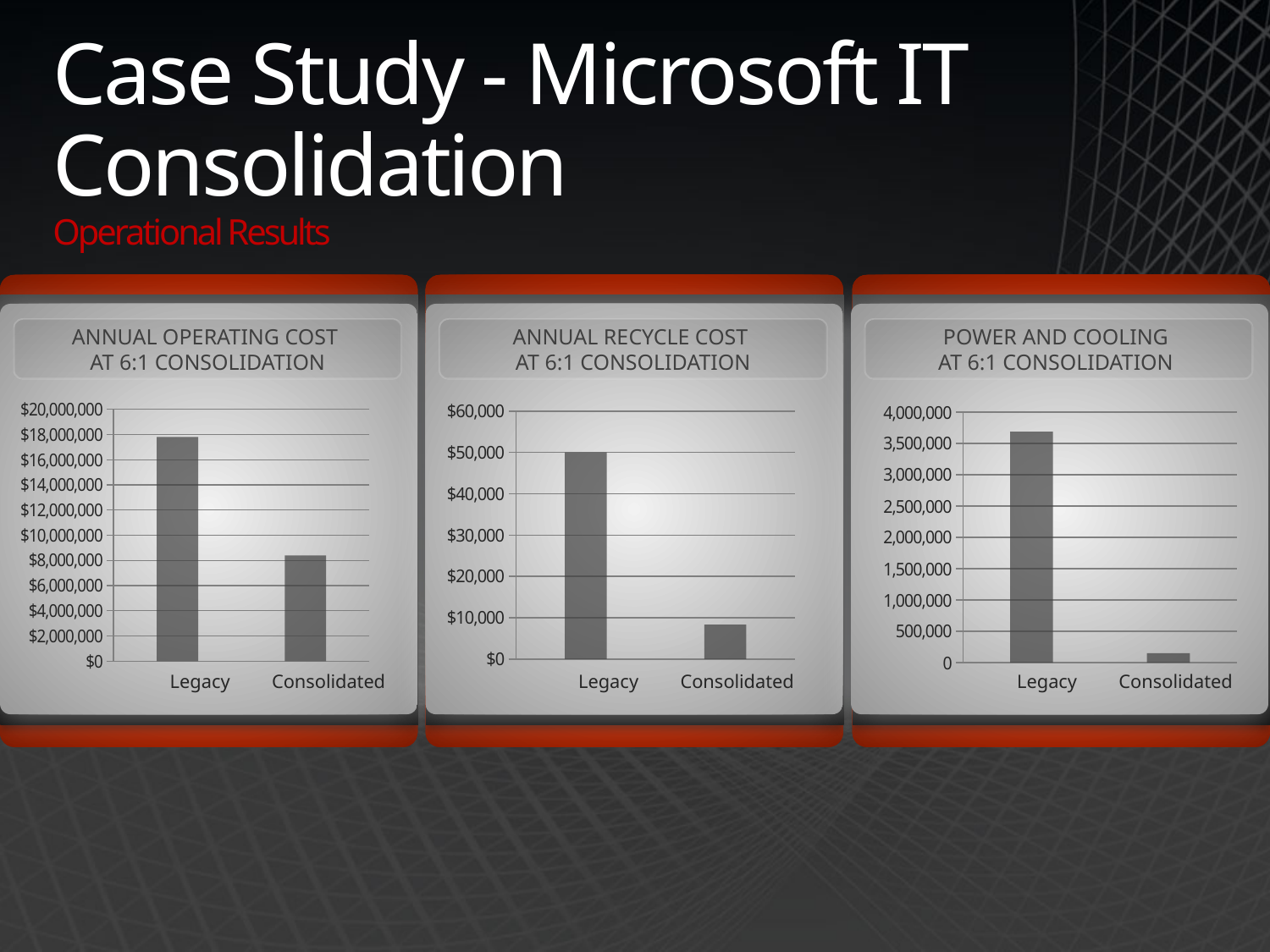
What type of chart is the Power and Cooling at 6:1 Consolidation chart? Bar chart In the Annual Recycle Cost at 6:1 Consolidation chart, which category has the lower value? Consolidated How many charts are shown on the slide? 3 In the Annual Recycle Cost at 6:1 Consolidation chart, what is the value for Legacy? $50,000 In the Power and Cooling at 6:1 Consolidation chart, is the value for Consolidated greater or less than 500,000? less In the Annual Operating Cost at 6:1 Consolidation chart, is the value for Consolidated greater or less than $10,000,000? less How many categories are shown in the Annual Operating Cost at 6:1 Consolidation chart? 2 In the Power and Cooling at 6:1 Consolidation chart, is the value for Legacy greater or less than 3,500,000? greater In the Power and Cooling at 6:1 Consolidation chart, is Legacy or Consolidated larger? Legacy In the Annual Operating Cost at 6:1 Consolidation chart, which category has the higher value? Legacy